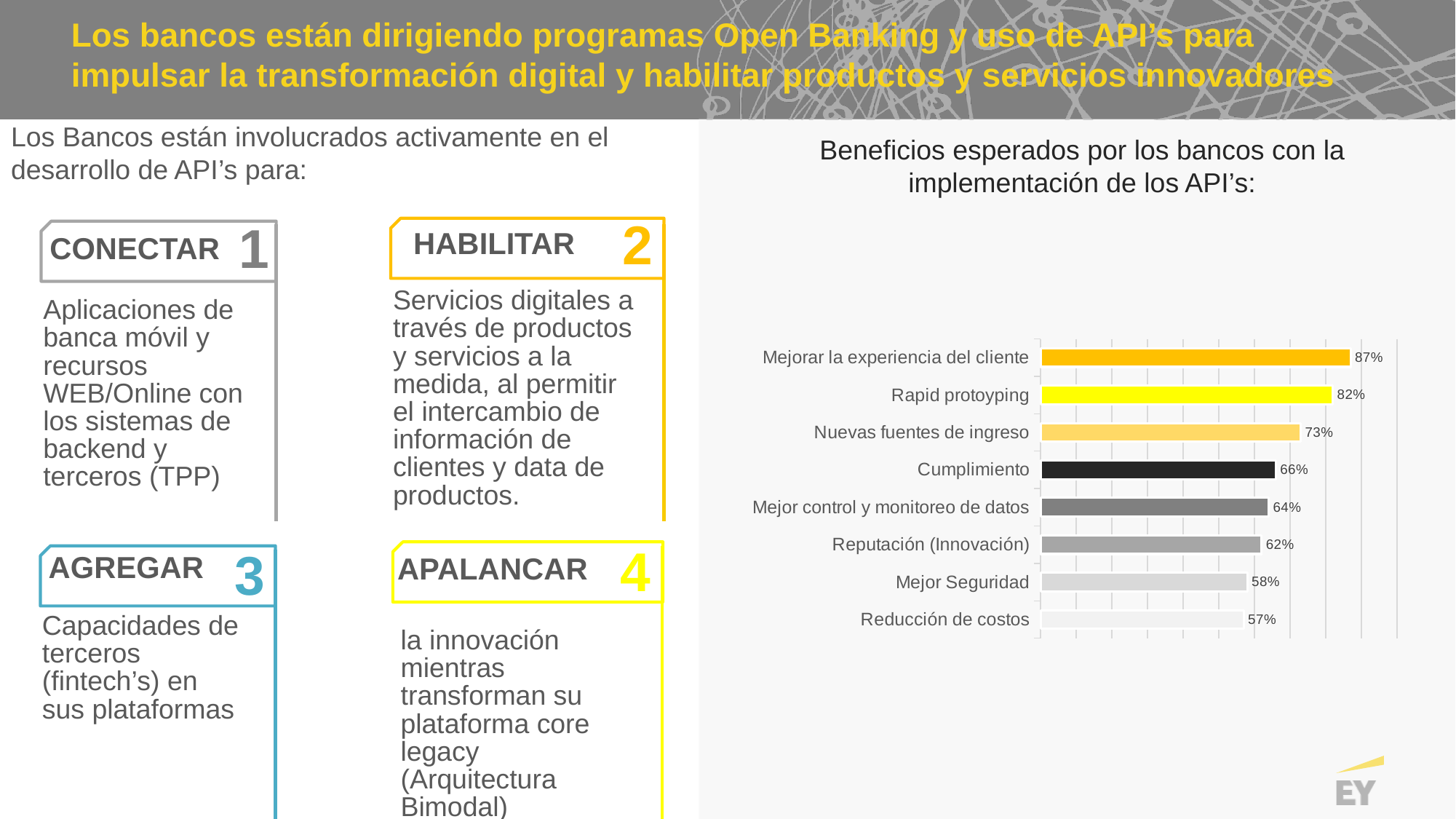
What is the title of the chart? Beneficios esperados por los bancos con la implementación de los API's: What is the value for Mejorar la experiencia del cliente? 87% What kind of chart is shown on the slide? Bar chart What is the value for Cumplimiento? 66% What is the value for Rapid protoyping? 82% What is the difference between Mejor control y monitoreo de datos and Mejor Seguridad? 6% What is the difference between Mejorar la experiencia del cliente and Nuevas fuentes de ingreso? 14% Which is larger, Reputación (Innovación) or Mejor Seguridad? Reputación (Innovación) Which category has the highest value? Mejorar la experiencia del cliente What is the value for Reducción de costos? 57% How many categories are shown in the chart? 8 Which category has the lowest value? Reducción de costos